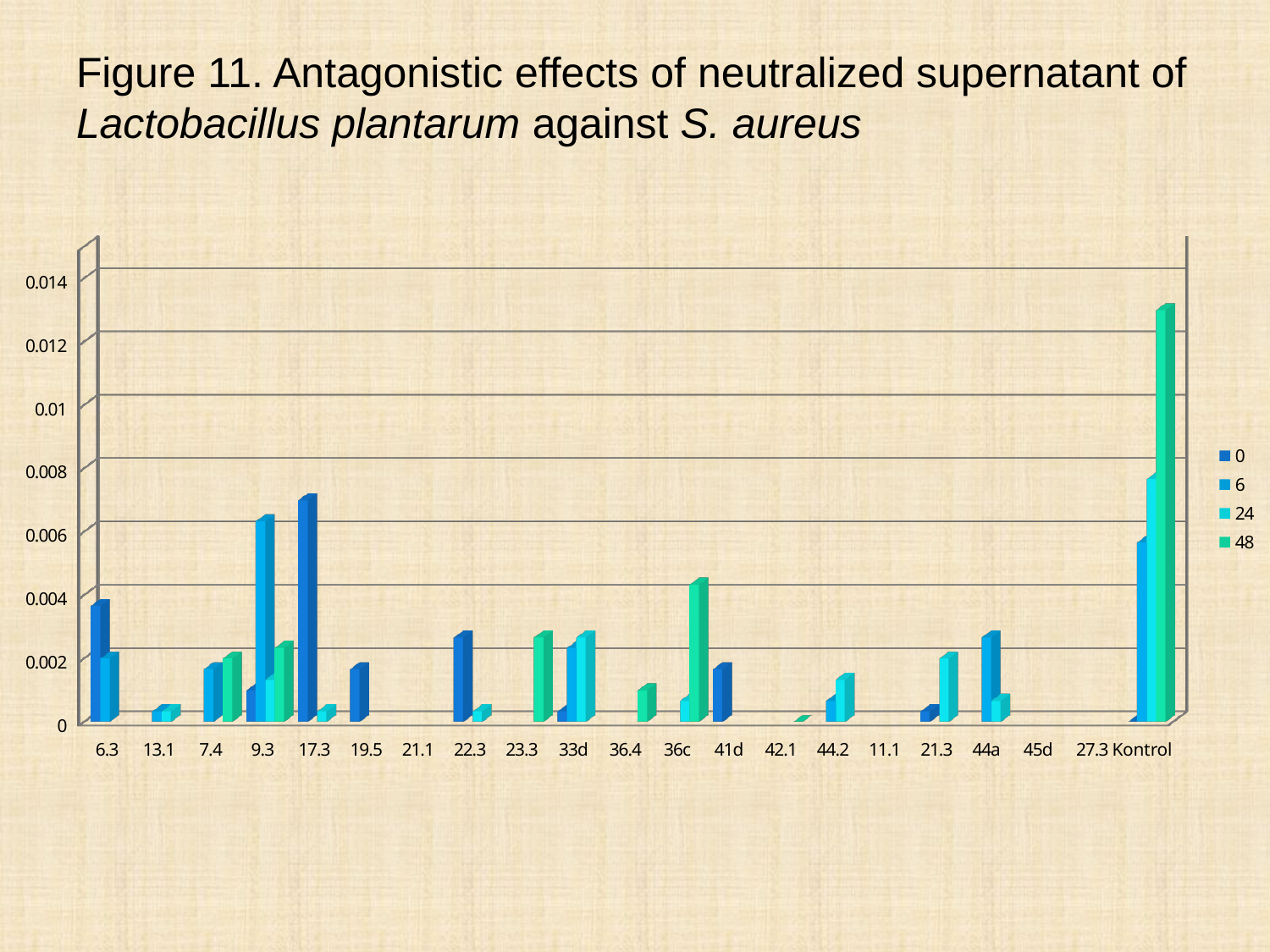
Which category has the tallest bar in the chart? Kontrol How many series does the legend list? 4 What are the series names listed in the legend? 0, 6, 24, 48 Is the value of the 6 series for 9.3 greater or less than 0.004? greater Is the value of the 48 series for Kontrol greater or less than 0.012? greater How many categories are shown along the x axis? 21 For the Kontrol category, which series has the highest bar? 48 Is the value of the 48 series for 36c greater or less than 0.002? greater Which is larger: the 48 series value for Kontrol or the 0 series value for 17.3? Kontrol What is the label of the last category on the x axis? Kontrol What kind of chart is shown on the slide? bar chart